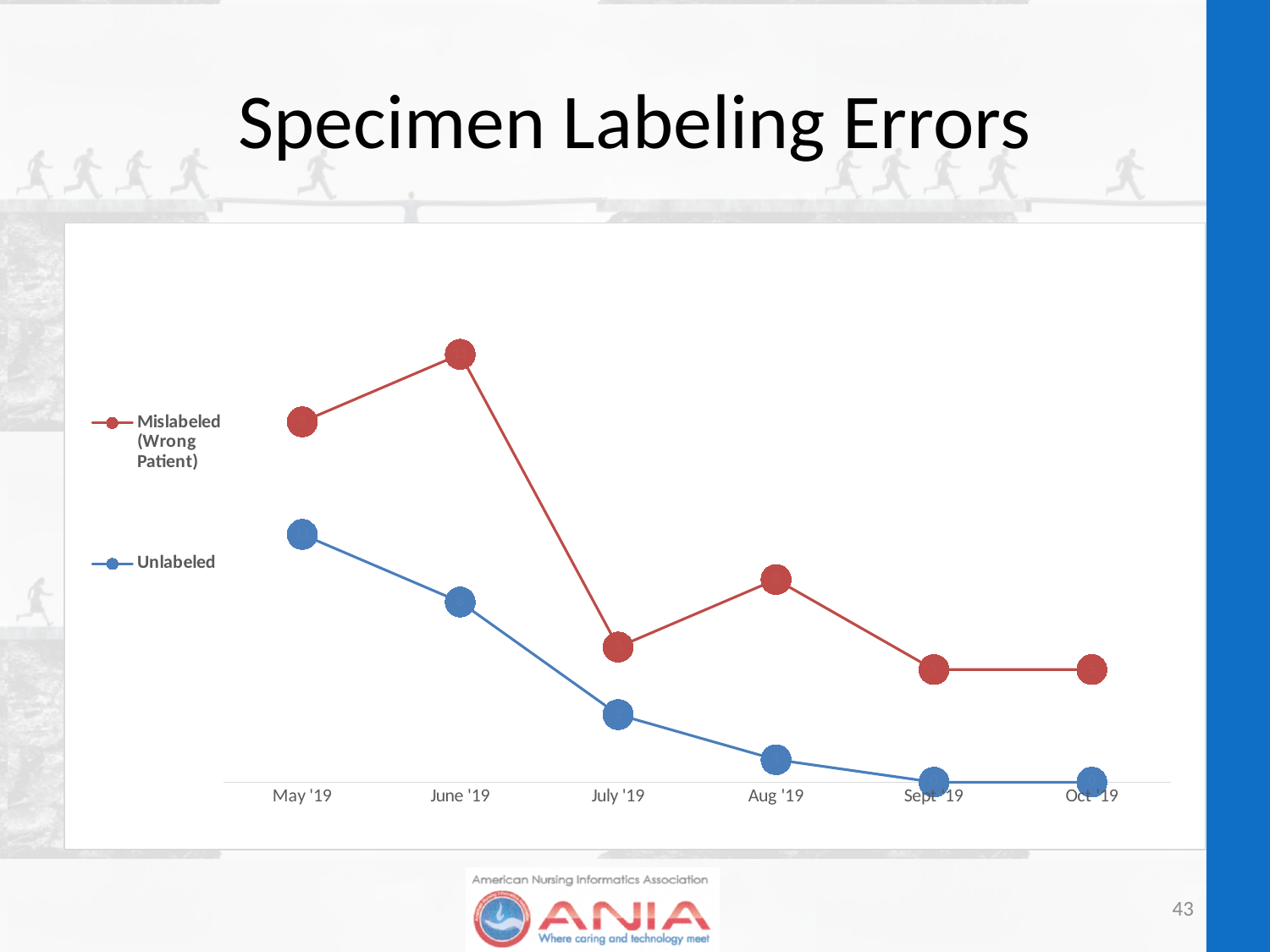
For the Unlabeled series, which month has the higher value, May '19 or June '19? May '19 For the Mislabeled (Wrong Patient) series, which month has the higher value, July '19 or Aug '19? Aug '19 Does the Mislabeled (Wrong Patient) series rise or fall from June '19 to July '19? fall How many series does the legend list? 2 In which month is the Mislabeled (Wrong Patient) series at its highest? June '19 Does the Unlabeled series rise or fall from May '19 to Oct '19? fall In which month is the Unlabeled series at its highest? May '19 How many months are plotted along the x axis? 6 What is the title of the slide containing the chart? Specimen Labeling Errors What colour is the line for the Unlabeled series? blue What kind of chart is shown on the slide? line chart